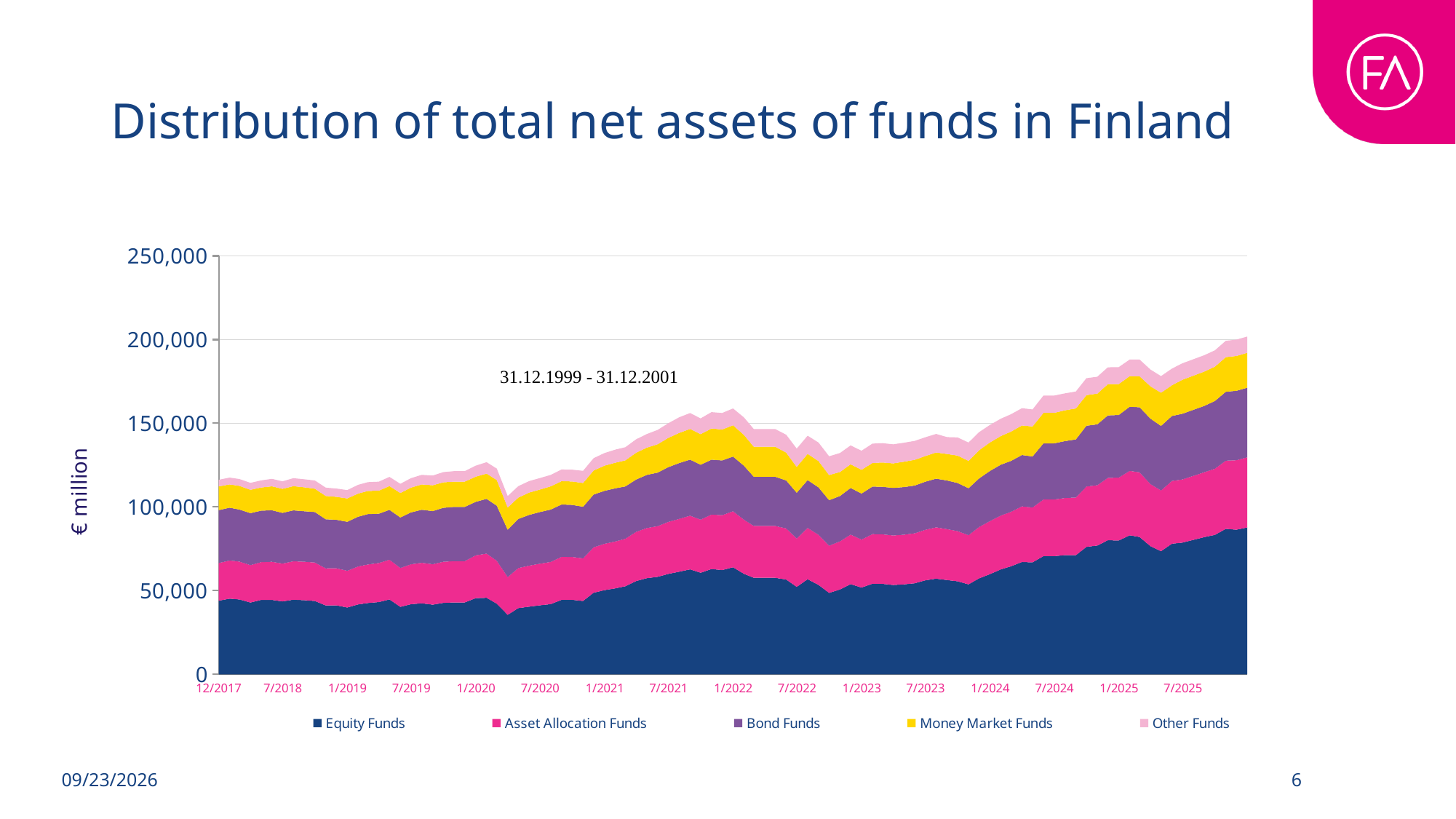
Is the total of all funds at 1/2020 greater or less than 150,000? less What is the label on the vertical axis? € million Which series is plotted at the bottom of the stack? Equity Funds At the last point on the chart, which is larger: Equity Funds or Other Funds? Equity Funds How many series does the legend list? 5 Which series has the largest value at the last point on the chart? Equity Funds Is the total of all funds at 12/2017 greater or less than 100,000? greater Is the value for Equity Funds at the last point on the chart greater or less than 50,000? greater What kind of chart is shown on the slide? Stacked area chart Do the values for Equity Funds rise or fall overall from 12/2017 to the end of the chart? rise